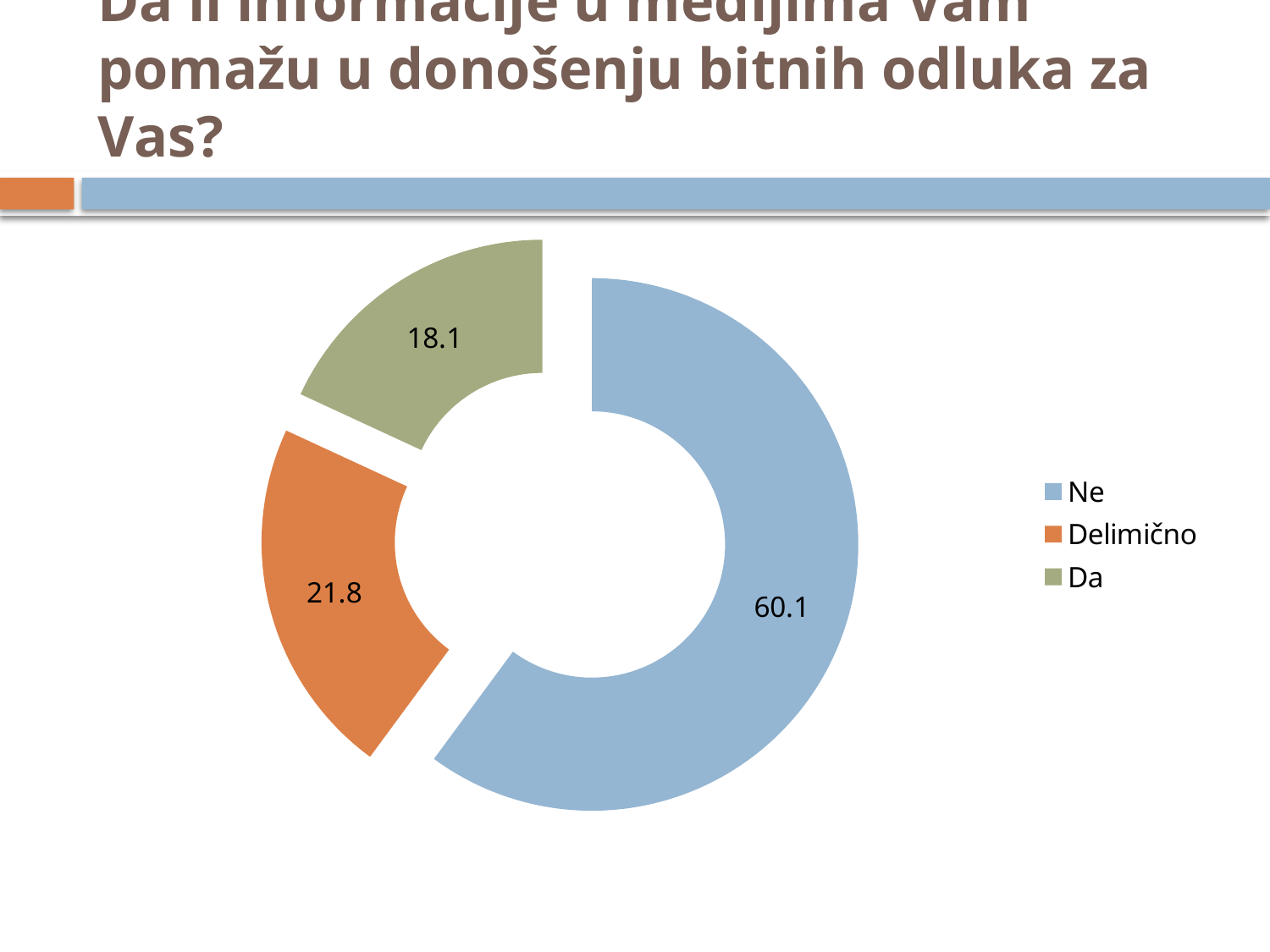
Which is larger, the value for "Delimično" or the value for "Da"? Delimično Which legend entry is shown in orange? Delimično What is the difference between the values for "Ne" and "Delimično"? 38.3 What kind of chart is shown on the slide? doughnut chart Which category has the smallest segment in the chart? Da What is the difference between the values for "Delimično" and "Da"? 3.7 What is the total of all three segment values in the chart? 100 How many categories does the chart show? 3 What value is shown for the "Delimično" segment? 21.8 What value is shown for the "Ne" segment? 60.1 Which category has the largest segment in the chart? Ne What value is shown for the "Da" segment? 18.1